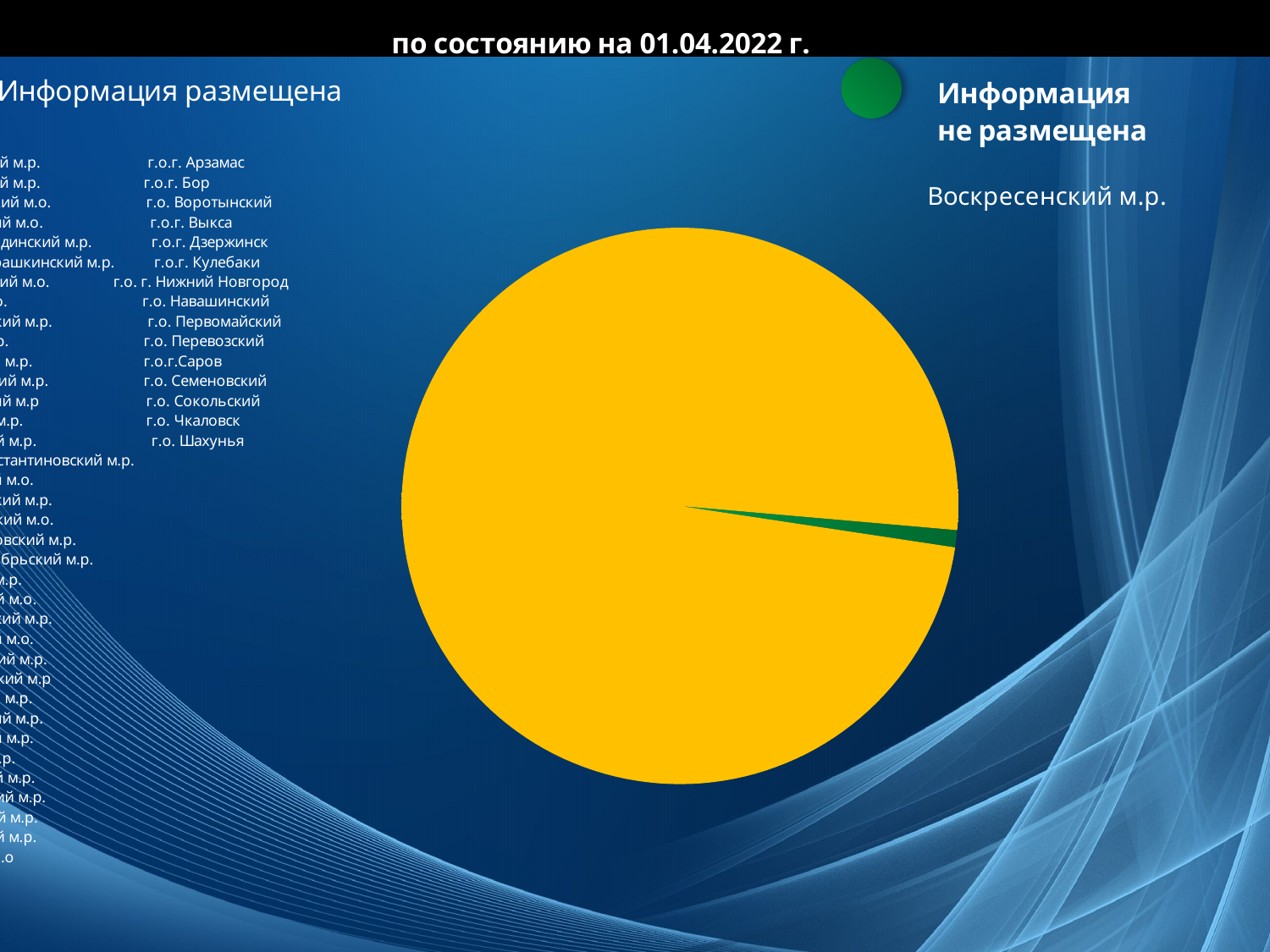
What colour is the slice for "Информация не размещена"? green Which category has the smallest slice of the pie chart? Информация не размещена What date is given in the heading above the pie chart? 01.04.2022 г. How many slices does the pie chart have? 2 Which slice is larger: "Информация размещена" or "Информация не размещена"? Информация размещена What kind of chart is shown on the slide? pie chart Which category has the largest slice of the pie chart? Информация размещена